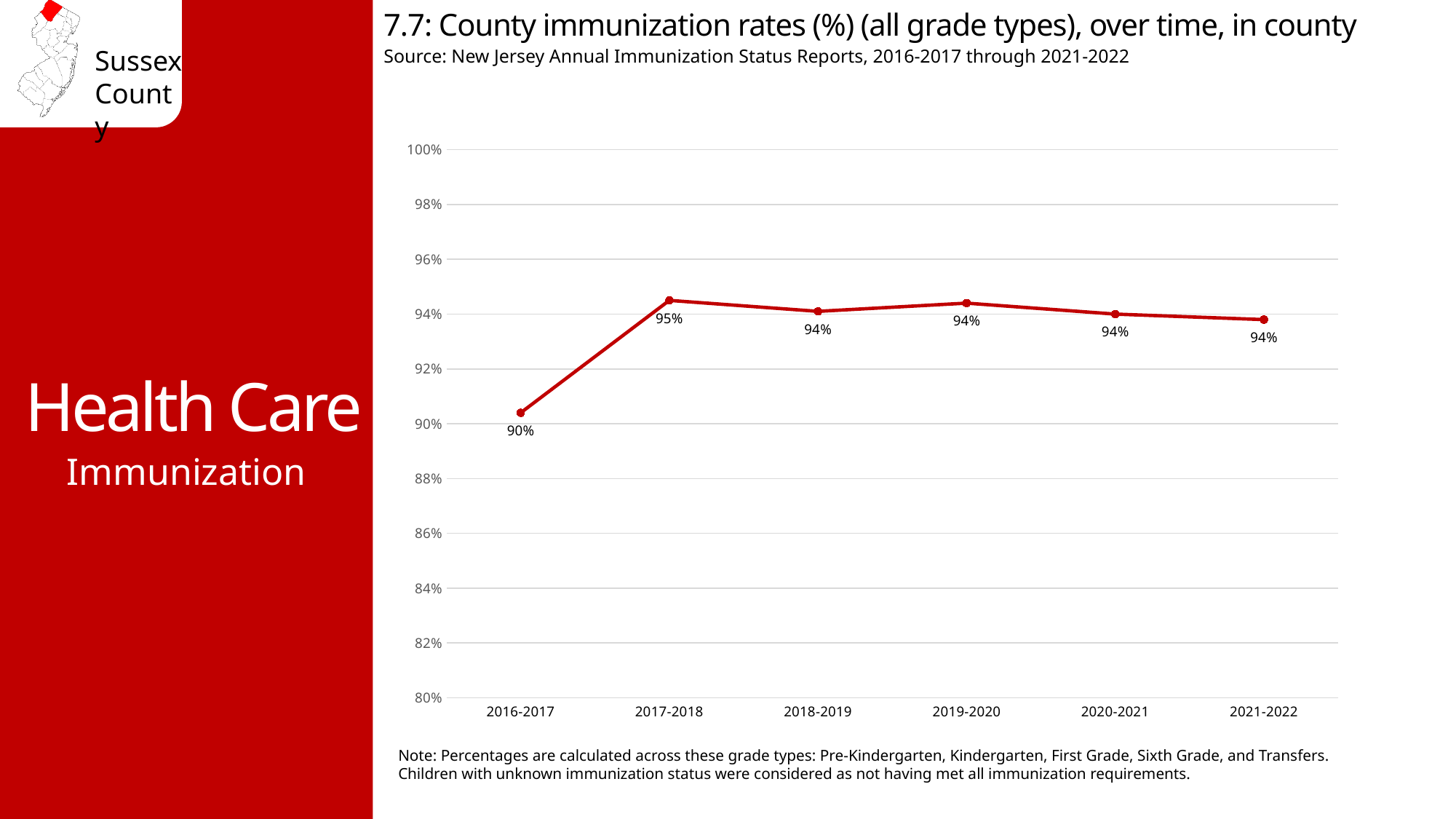
Which school year has the highest immunization rate? 2017-2018 What is the county immunization rate for 2021-2022? 94% What is the county immunization rate for 2017-2018? 95% Is the value for 2017-2018 greater or less than 96%? less What kind of chart is shown on the slide? Line chart Is the value for 2016-2017 greater or less than 92%? less Does the immunization rate rise or fall from 2016-2017 to 2017-2018? Rise How many school years are plotted on the chart? 6 What is the difference between the immunization rate in 2017-2018 and in 2016-2017? 5 percentage points What is the county immunization rate for 2016-2017? 90% Which school year has the lowest immunization rate? 2016-2017 Which is larger, the immunization rate in 2016-2017 or in 2017-2018? 2017-2018